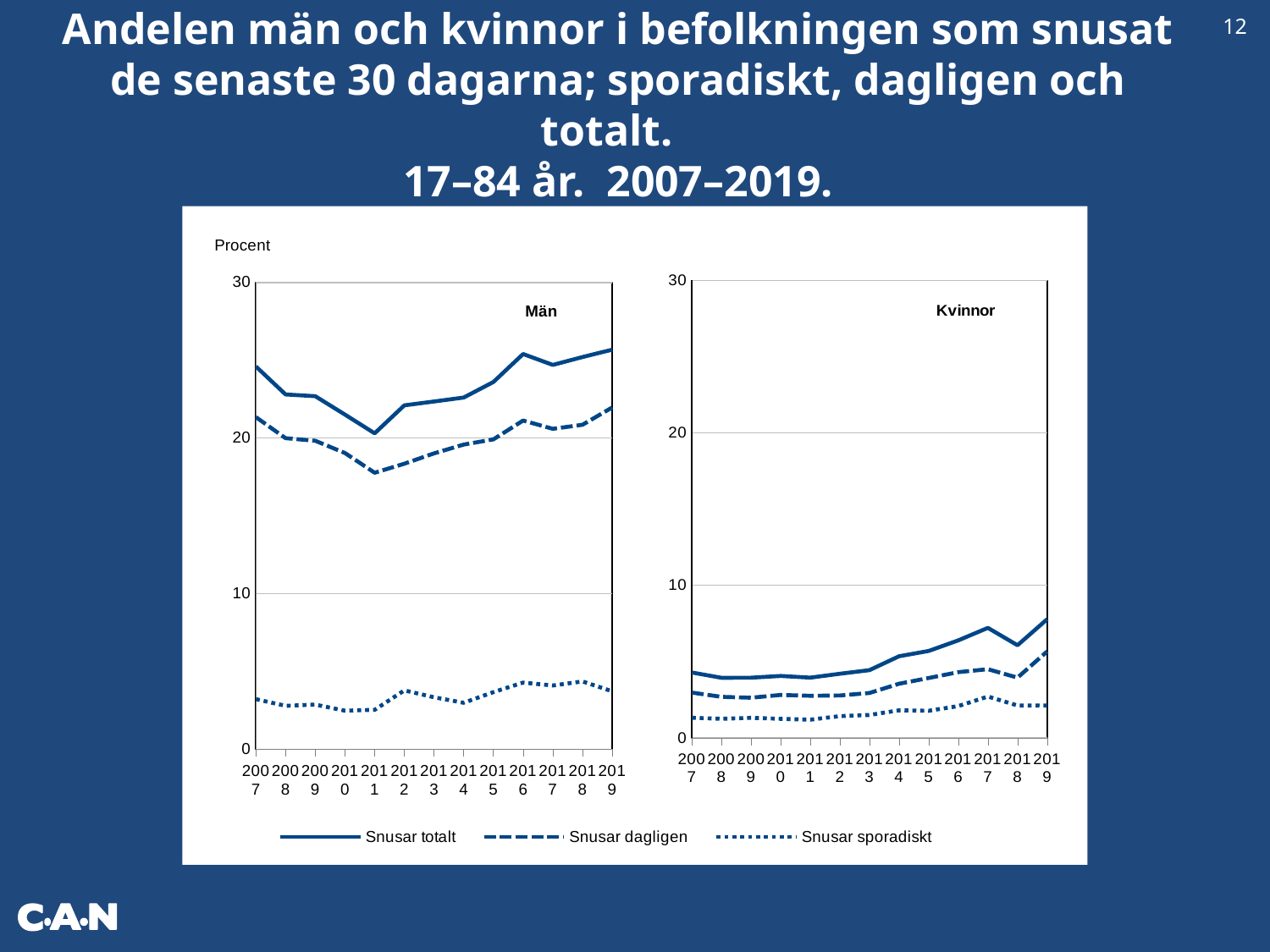
In the "Män" chart, does Snusar totalt rise or fall from 2007 to 2011? Fall In the "Män" chart, which year has the lowest value for Snusar totalt? 2011 What unit label is shown above the y axis of the charts? Procent In the "Kvinnor" chart, does Snusar totalt rise or fall from 2007 to 2019? Rise What kind of chart is the "Män" chart on the left? Line chart How many years are plotted along the x axis of the "Kvinnor" chart? 13 In the "Män" chart, is the value for Snusar totalt in 2019 greater or less than 20? greater Which is larger in 2019: Snusar totalt in the "Män" chart or Snusar totalt in the "Kvinnor" chart? Män How many series does the legend list? 3 In the "Män" chart, is the value for Snusar sporadiskt in 2019 greater or less than 10? less In the "Kvinnor" chart, is the value for Snusar totalt in 2019 greater or less than 10? less